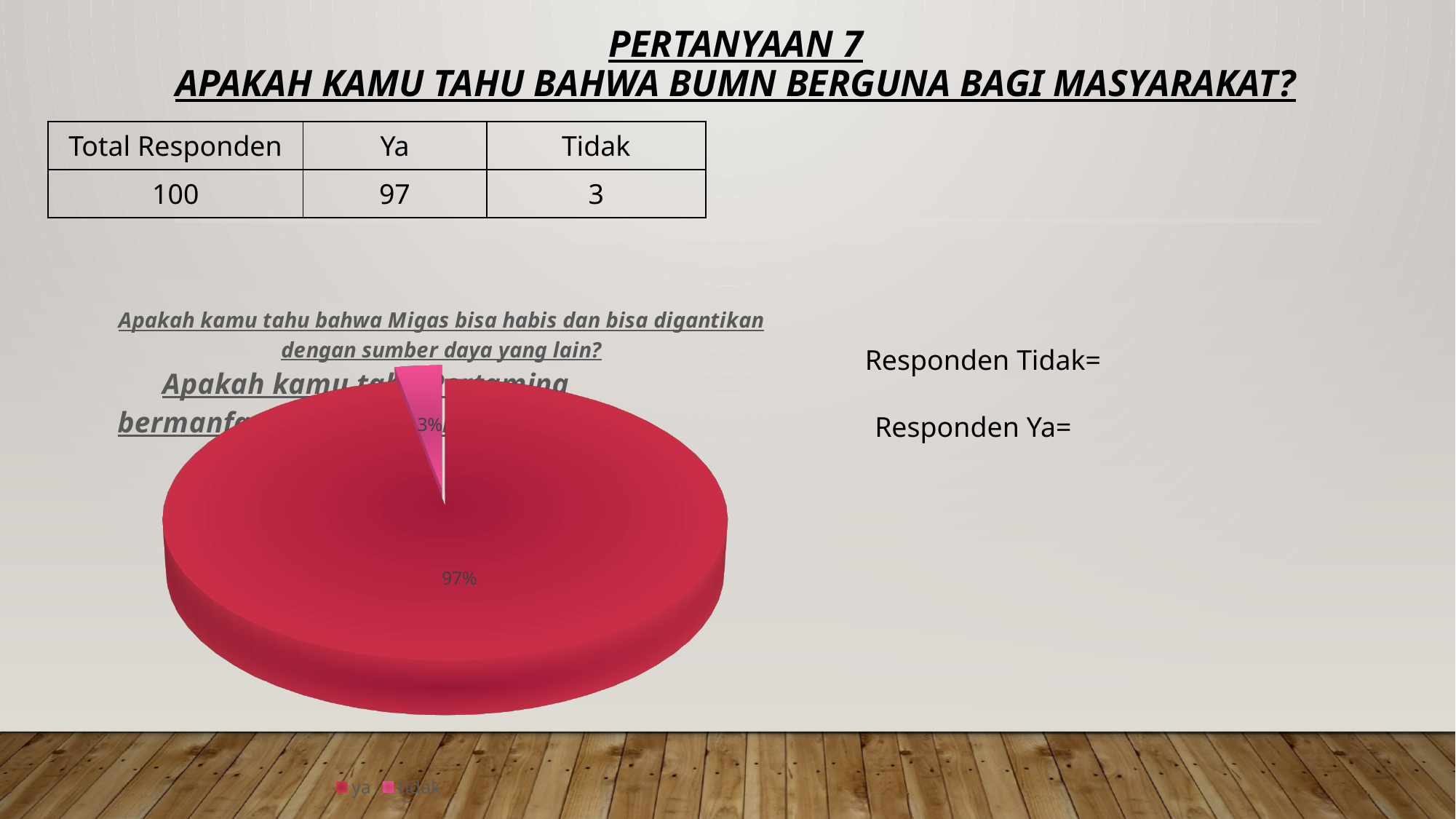
How many entries does the pie chart's legend list? 2 What percentage does the "ya" slice of the pie chart show? 97% Which slice of the pie chart is the smallest? tidak What share of the pie does the "ya" slice take? 97% What colour is the "tidak" slice in the pie chart? pink What is the difference in percentage points between the "ya" and "tidak" slices? 94 What kind of chart is shown on the slide? pie chart What are the two legend entries of the pie chart? ya, tidak Which is larger in the pie chart, "ya" or "tidak"? ya How many slices does the pie chart have? 2 What percentage does the "tidak" slice of the pie chart show? 3% Which slice of the pie chart is the largest? ya